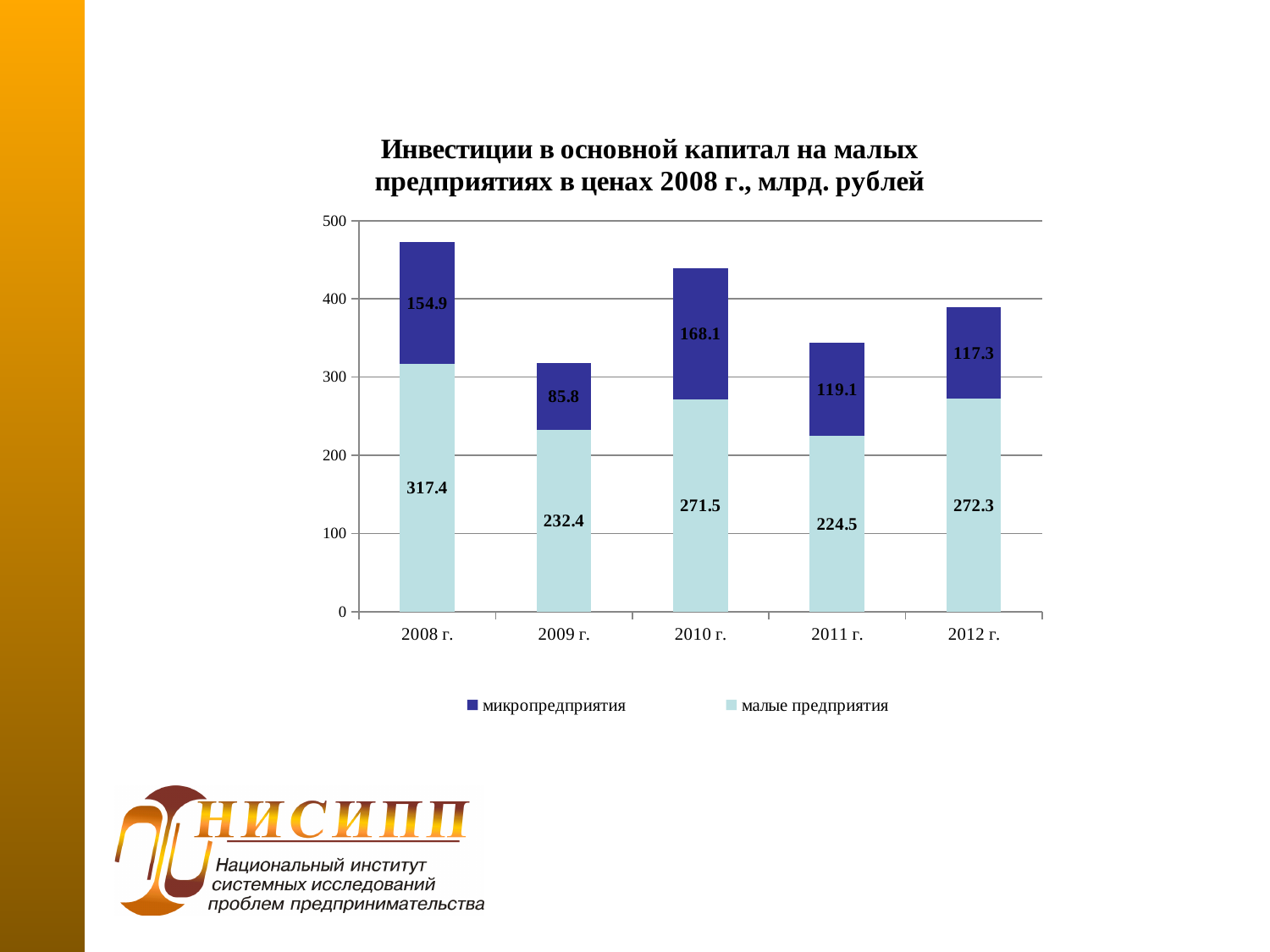
What is the difference between the малые предприятия values for 2008 г. and 2009 г.? 85.0 What is the value for микропредприятия in 2009 г.? 85.8 How many years are shown on the x axis? 5 What is the value for малые предприятия in 2012 г.? 272.3 In which year is the value for малые предприятия the lowest? 2011 г. How many series does the legend list? 2 What is the total of the stacked bar for 2009 г.? 318.2 Which is larger: the микропредприятия value for 2011 г. or for 2012 г.? 2011 г. What kind of chart is shown on the slide? Stacked bar chart What is the value for малые предприятия in 2010 г.? 271.5 In which year is the value for микропредприятия the highest? 2010 г. What is the total of the stacked bar for 2008 г.? 472.3